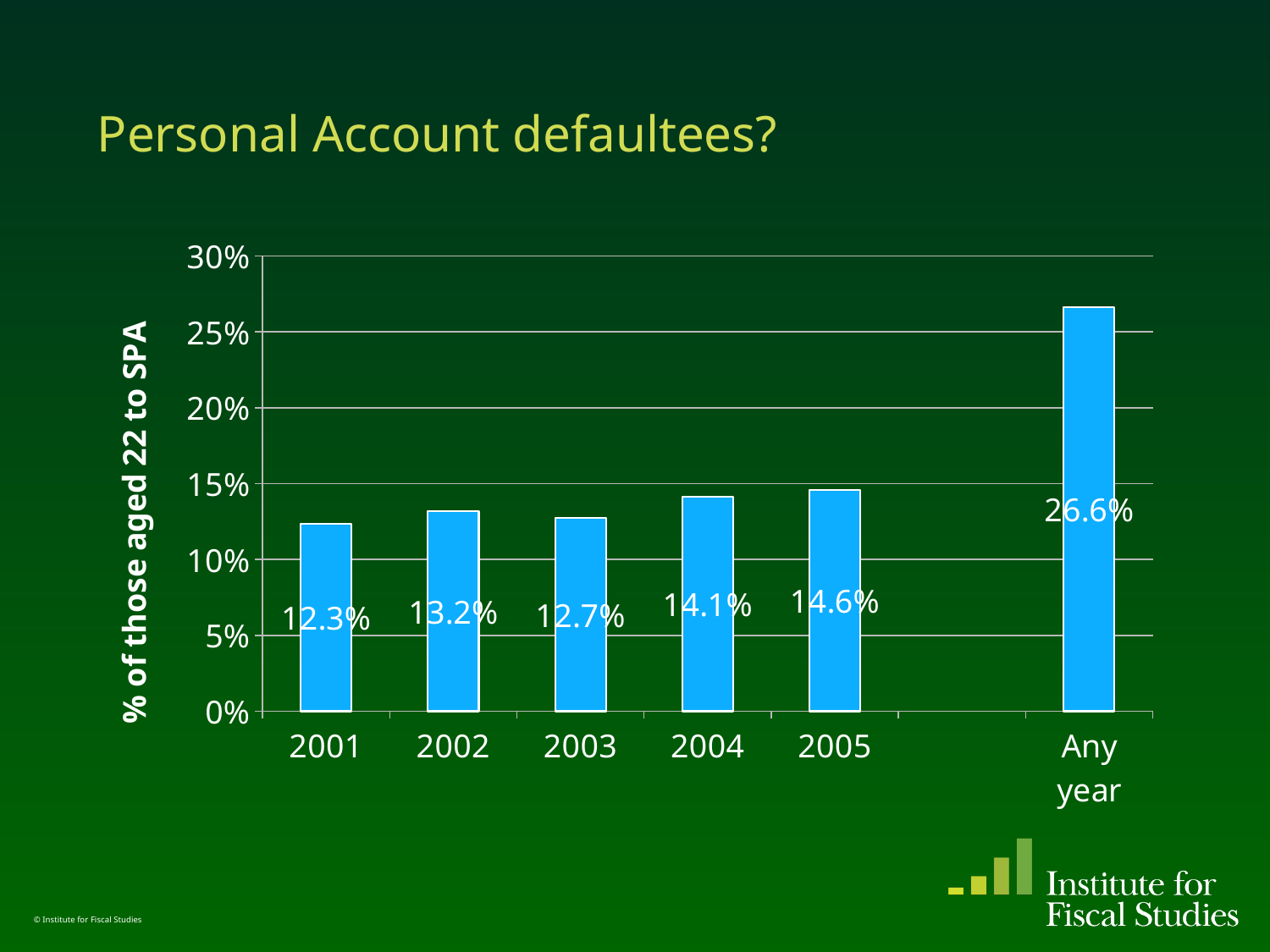
What is the difference between the values for 2005 and 2001? 2.3% What is the title of the slide? Personal Account defaultees? What is the value for Any year? 26.6% What kind of chart is this? bar chart What is the label on the y axis? % of those aged 22 to SPA Is the value for Any year greater or less than 25%? greater What is the value for 2004? 14.1% Which category has the highest value? Any year How many categories are shown on the x axis? 6 Which is larger, the value for 2002 or the value for 2003? 2002 What is the value for 2001? 12.3% Which category has the lowest value? 2001